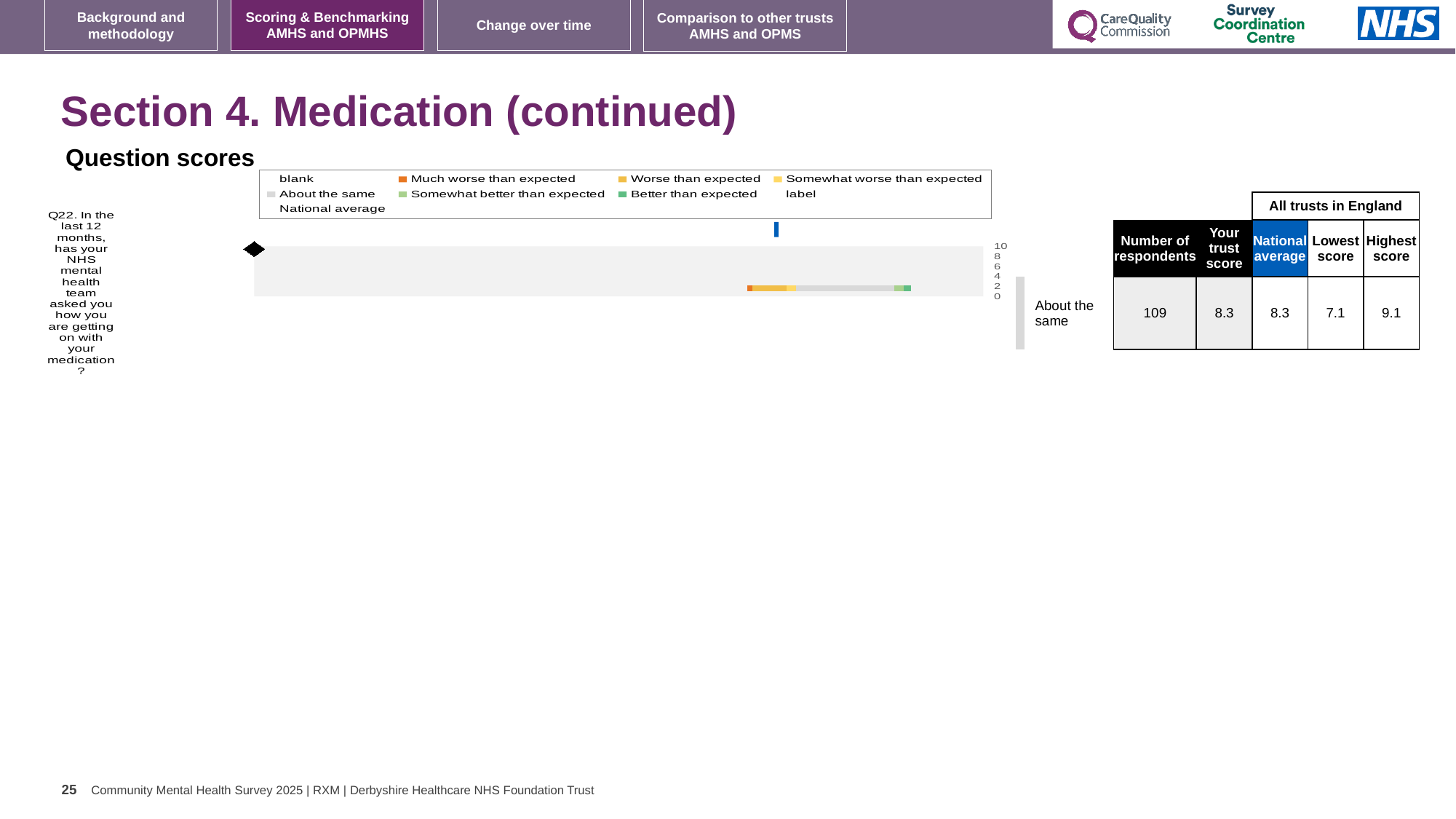
How many questions are plotted in the 'Question scores' chart? 1 What is the trust score for Q22 shown next to the chart? 8.3 Which benchmark category is the trust's Q22 score placed in? About the same How many entries does the legend of the 'Question scores' chart list? 9 What is the highest tick value shown on the axis of the 'Question scores' chart? 10 What kind of chart is shown under 'Question scores'? bar chart What is the difference between the highest score and the lowest score for Q22? 2.0 What is the lowest score among all trusts in England for Q22? 7.1 How many respondents answered Q22? 109 What is the highest score among all trusts in England for Q22? 9.1 What is the national average for Q22 shown next to the chart? 8.3 Which question is plotted in the 'Question scores' chart? Q22. In the last 12 months, has your NHS mental health team asked you how you are getting on with your medication?